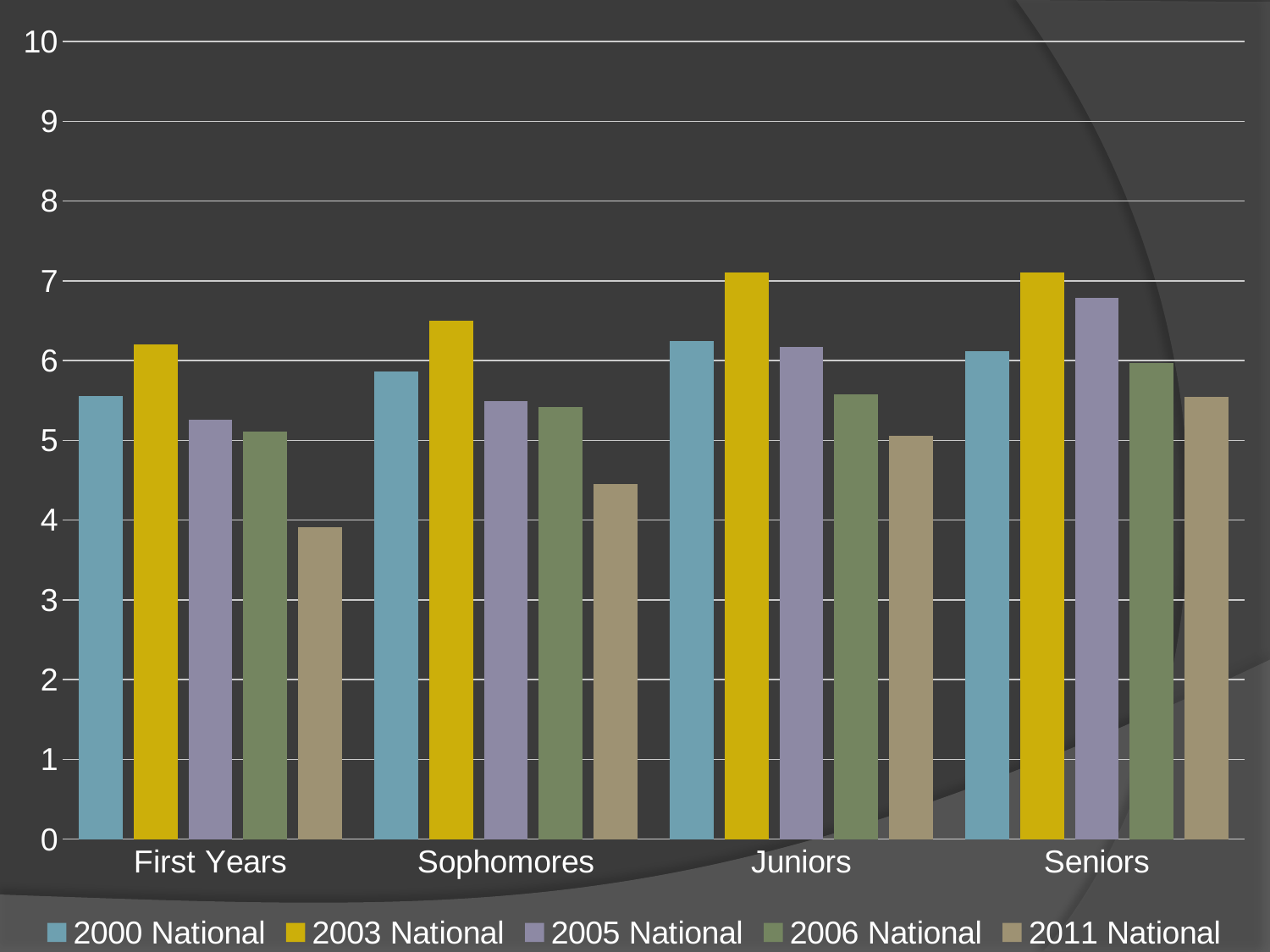
Is the value for 2003 National for Juniors greater or less than 7? greater How many categories are shown on the x axis? 4 Is the value for 2011 National for Sophomores greater or less than 5? less What kind of chart is shown on the slide? bar chart Which series has the highest value for First Years? 2003 National Is the value for 2011 National for First Years greater or less than 4? less How many series does the legend list? 5 Which series has the lowest value for First Years? 2011 National Which series has the lowest value for Seniors? 2011 National Which series has the highest value for Seniors? 2003 National For Sophomores, which is larger: 2000 National or 2005 National? 2000 National Do the values for 2011 National rise or fall from First Years to Seniors? rise